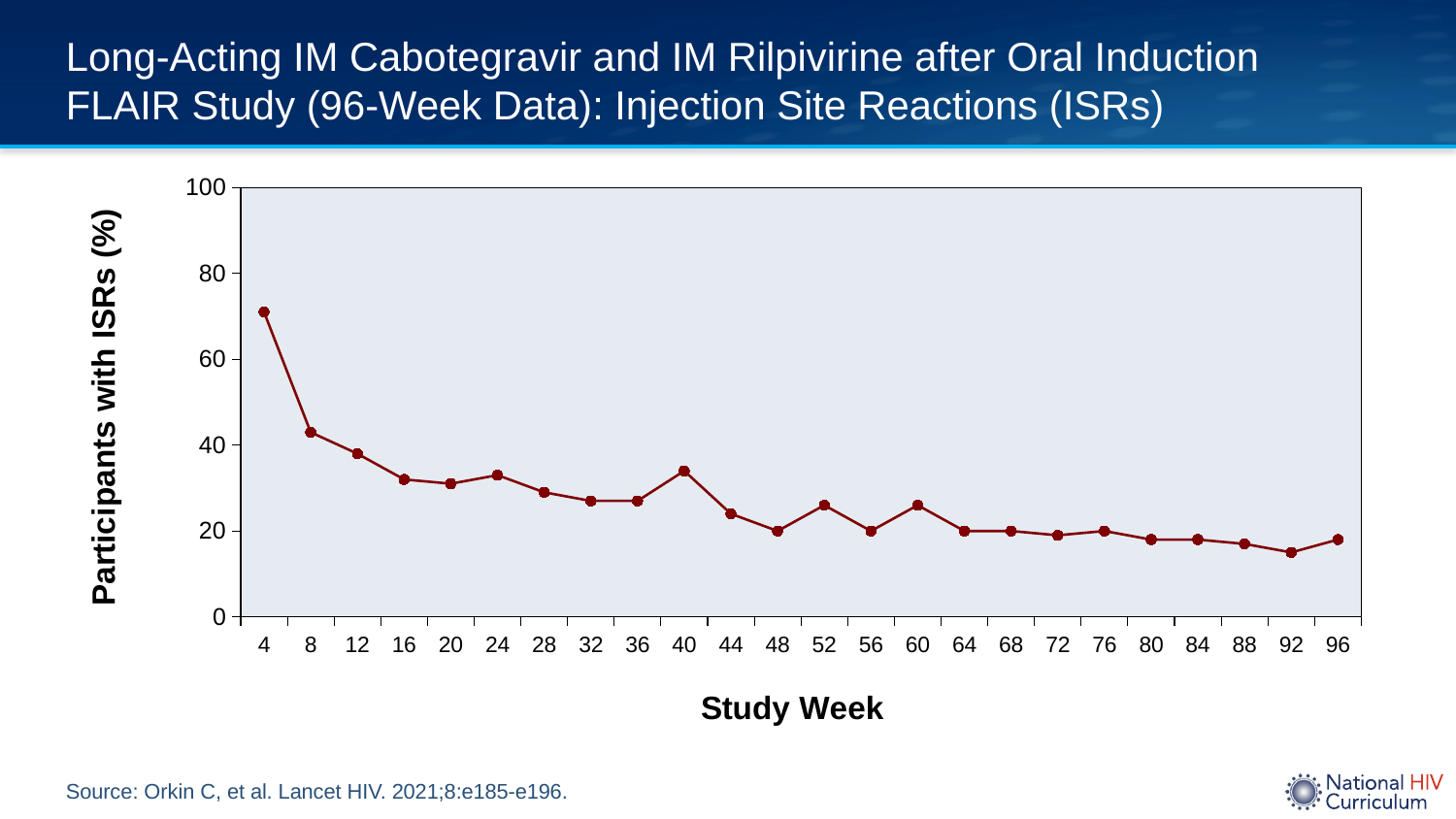
How many data points are plotted on the chart? 24 At which study week is the percentage of participants with ISRs highest? Week 4 Which has a higher percentage of participants with ISRs, study week 40 or study week 44? Study week 40 Is the value for study week 48 greater or less than 40? less What is the label on the y-axis of the chart? Participants with ISRs (%) Is the value for study week 92 greater or less than 20? less What kind of chart is shown on the slide? Line chart Which has a higher percentage of participants with ISRs, study week 4 or study week 8? Study week 4 Is the value for study week 4 greater or less than 60? greater Do the values generally rise or fall as the study week increases? Fall